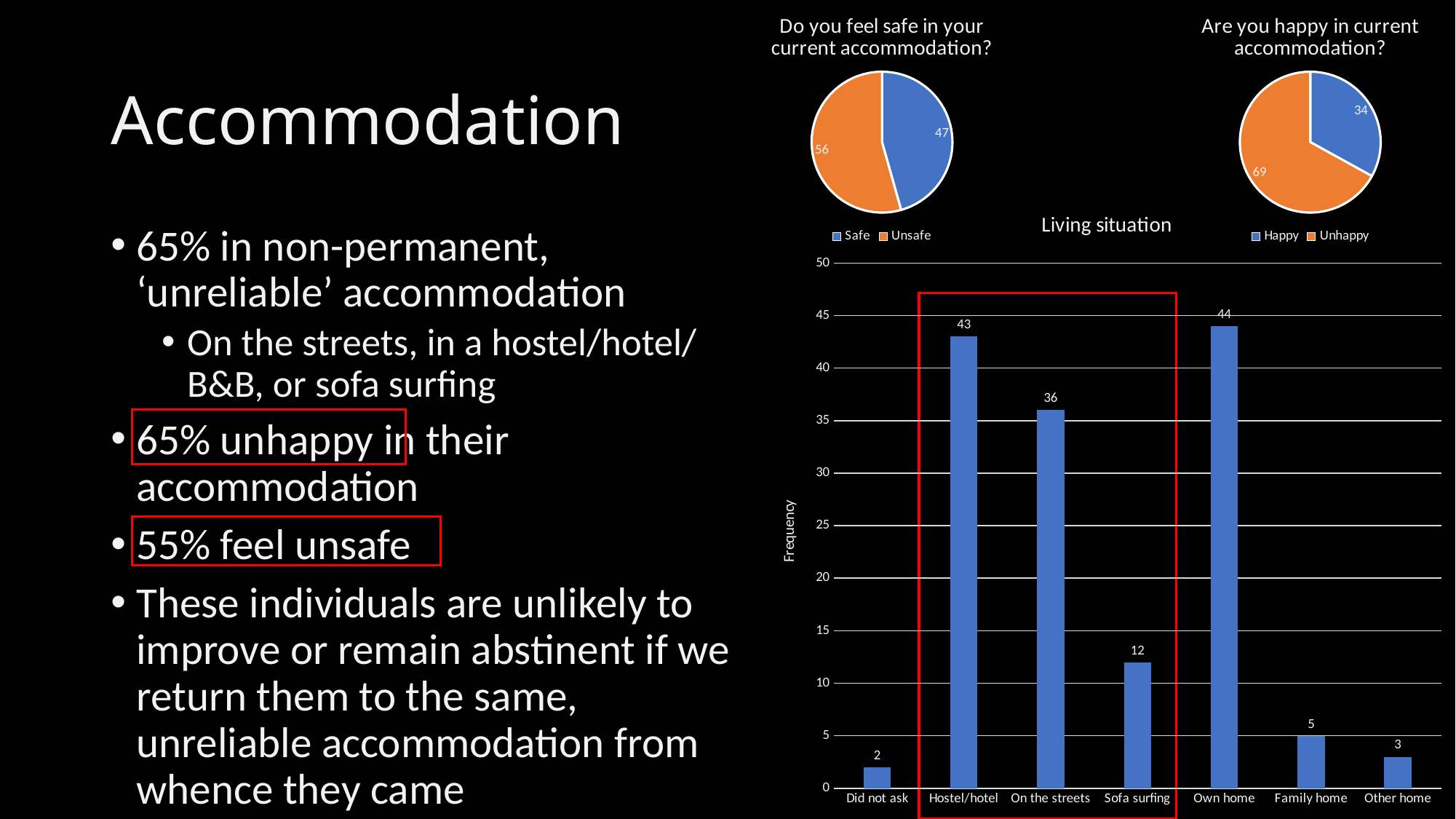
In the 'Living situation' bar chart, what is the frequency for Hostel/hotel? 43 How many categories are shown on the x axis of the 'Living situation' bar chart? 7 In the 'Do you feel safe in your current accommodation?' pie chart, what is the difference between the Unsafe and Safe values? 9 In the 'Do you feel safe in your current accommodation?' pie chart, what is the value for Unsafe? 56 What kind of chart is the 'Living situation' chart? bar chart In the 'Living situation' bar chart, is the value for Own home greater or less than 40? greater In the 'Are you happy in current accommodation?' pie chart, which slice is larger, Happy or Unhappy? Unhappy In the 'Living situation' bar chart, what is the frequency for Sofa surfing? 12 In the 'Living situation' bar chart, which is larger, the frequency for On the streets or for Family home? On the streets What is the y-axis label of the 'Living situation' bar chart? Frequency In the 'Living situation' bar chart, what is the difference between the frequencies for Hostel/hotel and On the streets? 7 In the 'Are you happy in current accommodation?' pie chart, what is the value for Happy? 34